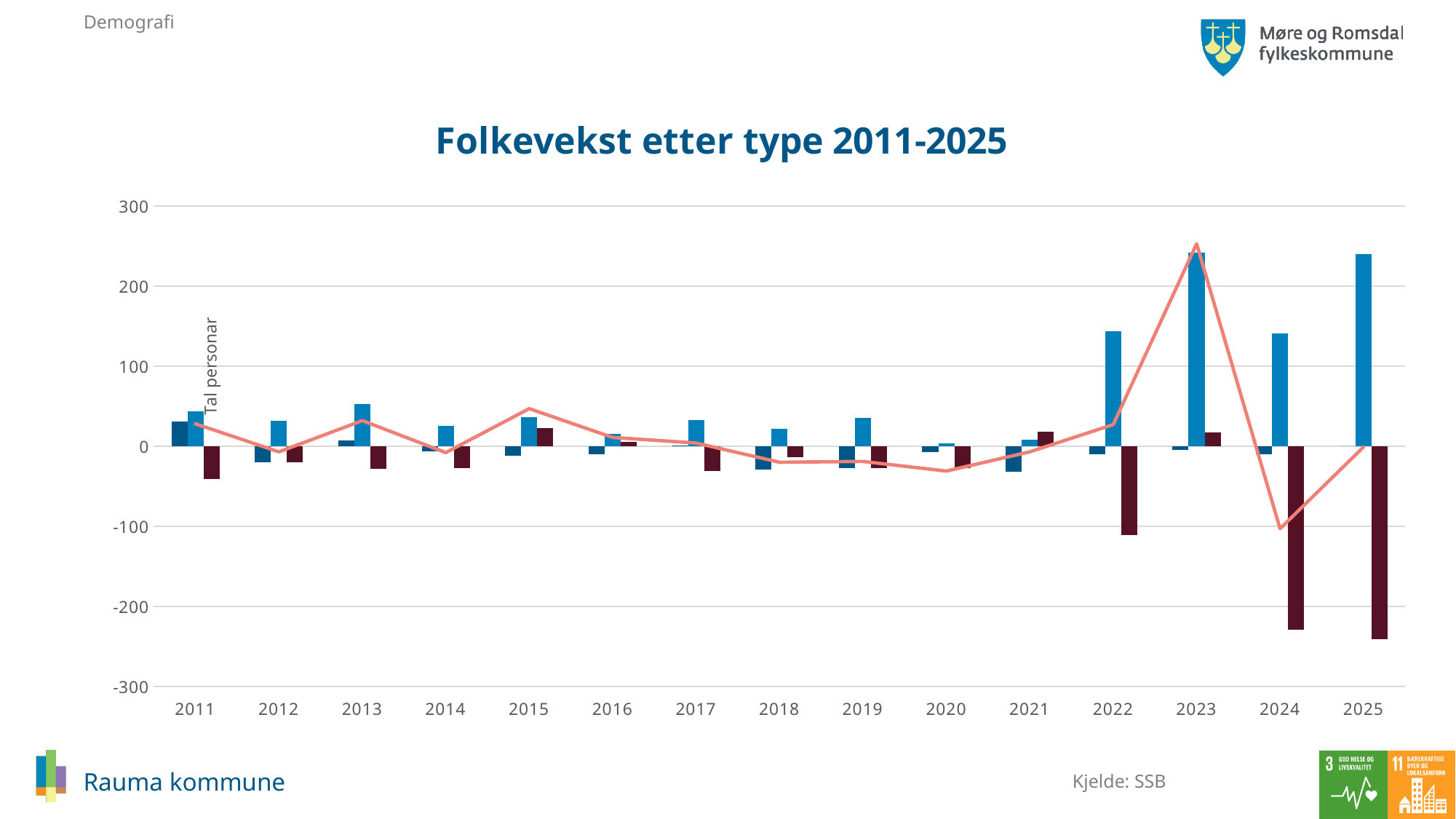
Is the value of the dark red bar for 2025 greater or less than -200? less What is the title of the chart? Folkevekst etter type 2011-2025 What is the label on the vertical axis of the chart? Tal personar Which year has the larger light blue bar, 2019 or 2022? 2022 In which year does the line reach its highest point? 2023 How many years are shown on the x axis of the chart? 15 Is the value of the light blue bar for 2023 greater or less than 200? greater In which year does the line reach its lowest point? 2024 Is the value of the line for 2023 greater or less than 200? greater What kind of chart is shown on the slide? bar chart with a line Does the line rise or fall from 2023 to 2024? fall